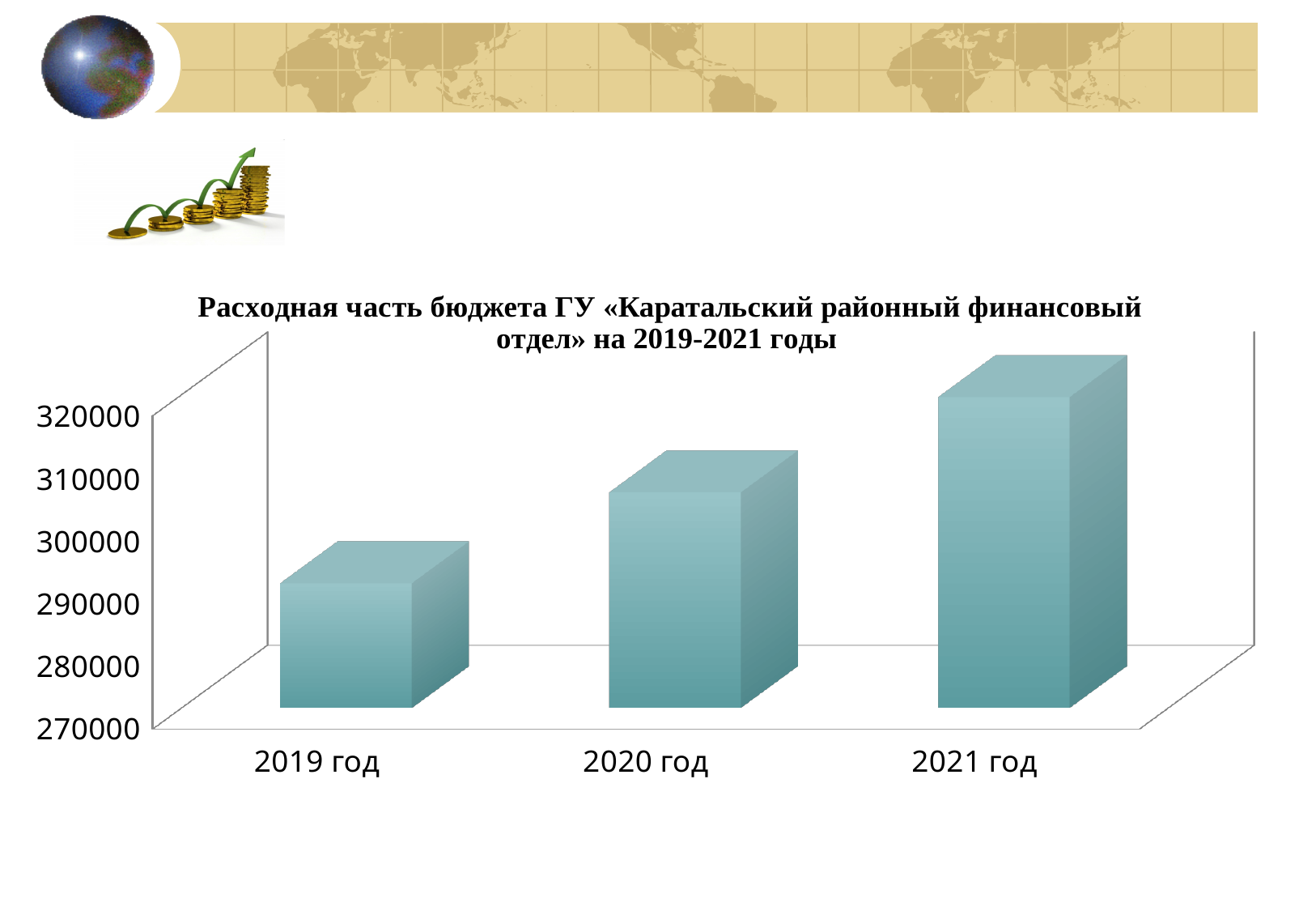
Is the value for 2019 год greater or less than 300000? less Which year has the highest value in the chart? 2021 год Is the value for 2020 год greater or less than 290000? greater Which is larger, the value for 2020 год or the value for 2021 год? 2021 год Do the values rise or fall from 2019 год to 2021 год? rise Which is larger, the value for 2020 год or the value for 2019 год? 2020 год How many categories (years) are plotted in the chart? 3 Is the value for 2021 год greater or less than 310000? greater Which year has the lowest value in the chart? 2019 год What kind of chart is shown on the slide? bar chart What is the title of the chart? Расходная часть бюджета ГУ «Каратальский районный финансовый отдел» на 2019-2021 годы